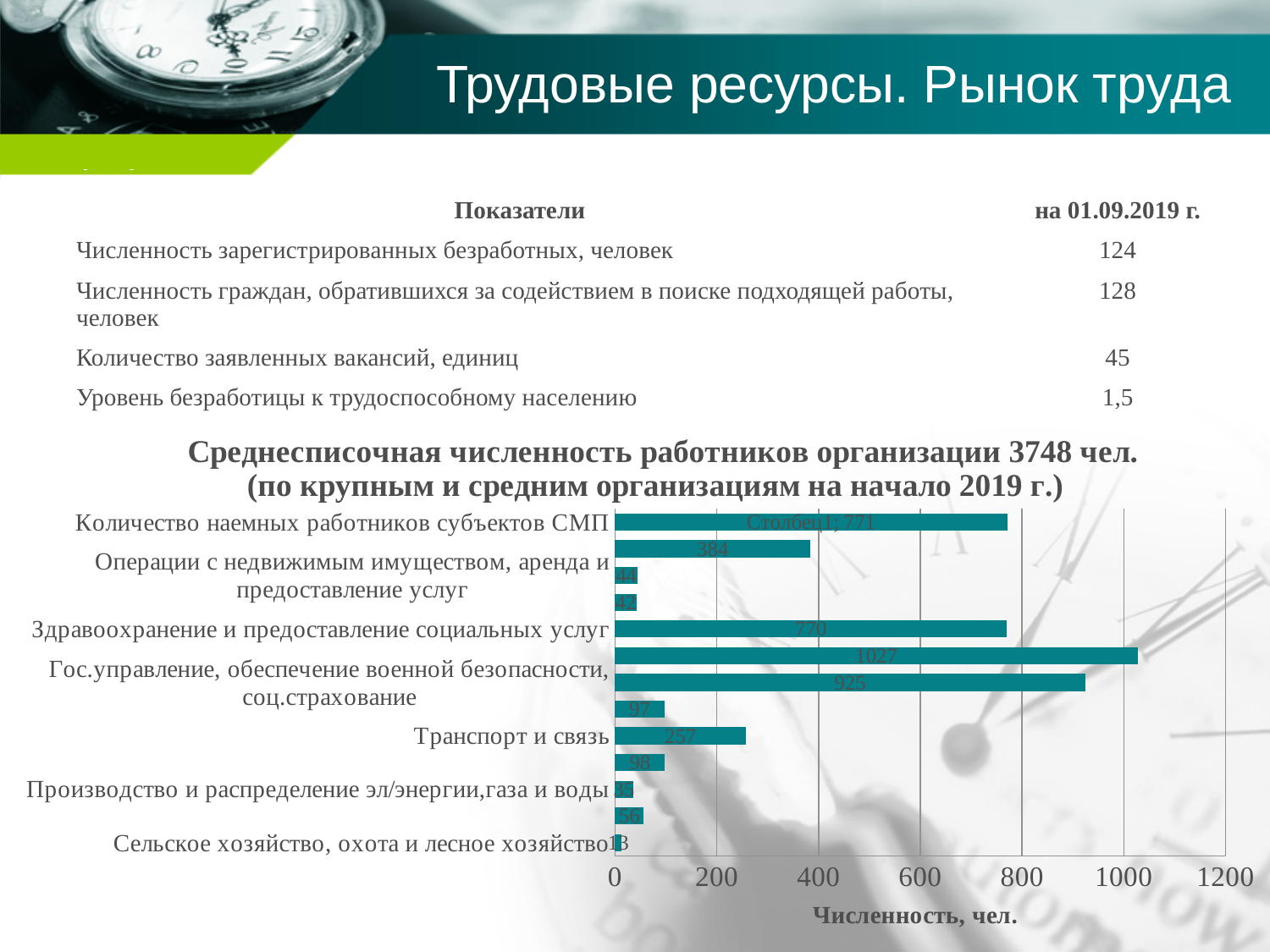
What kind of chart is shown on the slide? bar chart Which labelled category has the lowest value? Сельское хозяйство, охота и лесное хозяйство What is the value for "Производство и распределение эл/энергии,газа и воды"? 35 What is the value for "Здравоохранение и предоставление социальных услуг"? 770 What is the title of the horizontal axis of the chart? Численность, чел. What is the value for "Количество наемных работников субъектов СМП"? 771 What is the largest value shown on any bar in the chart? 1027 What is the difference between the values for "Транспорт и связь" and "Производство и распределение эл/энергии,газа и воды"? 222 Which is larger: the value for "Транспорт и связь" or for "Сельское хозяйство, охота и лесное хозяйство"? Транспорт и связь What is the value for "Сельское хозяйство, охота и лесное хозяйство"? 13 What is the value for "Транспорт и связь"? 257 Is the value for "Здравоохранение и предоставление социальных услуг" greater or less than 600? greater